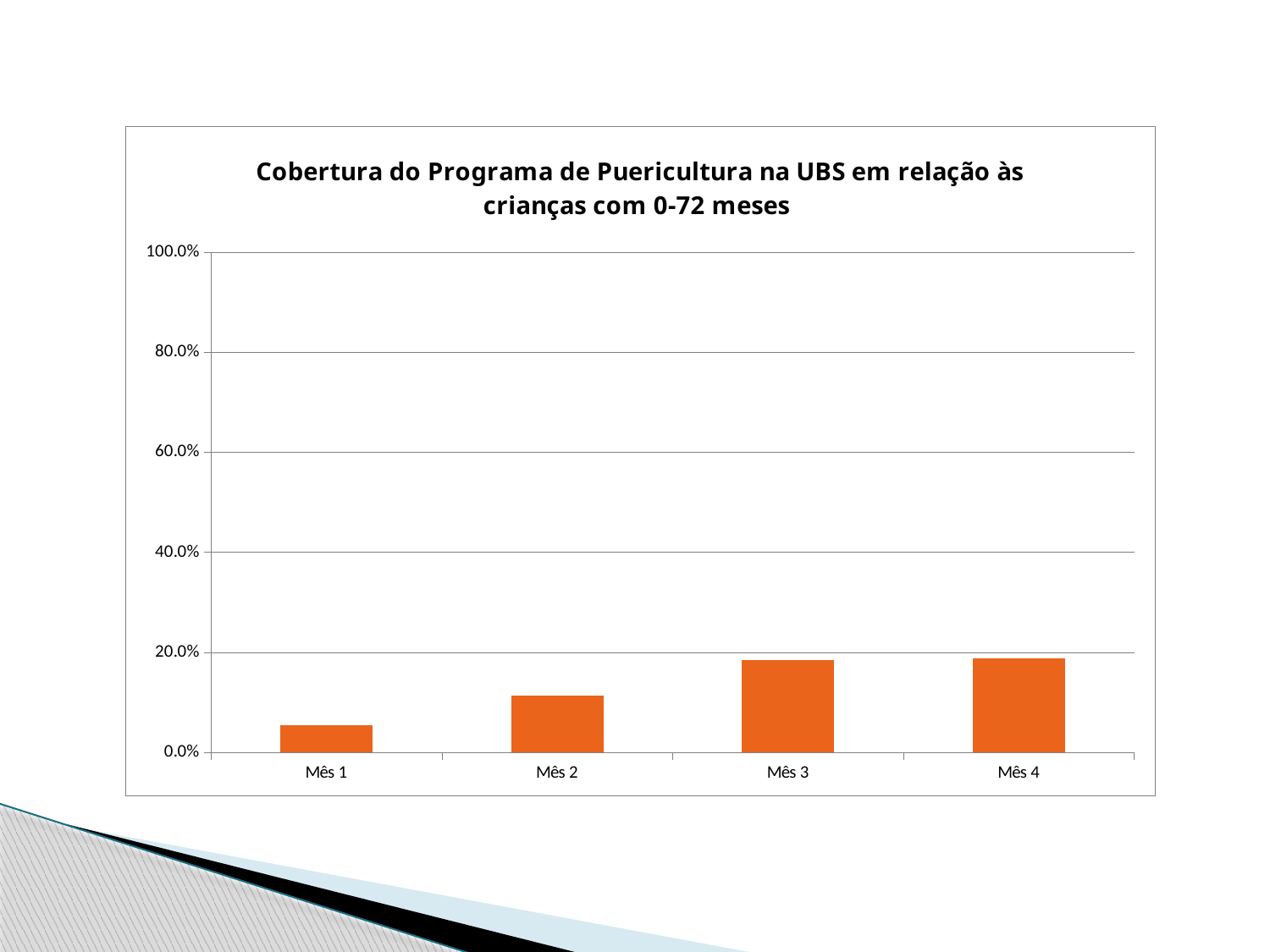
Which is larger, the value for Mês 2 or the value for Mês 4? Mês 4 What kind of chart is shown on the slide? bar chart Which is larger, the value for Mês 1 or the value for Mês 3? Mês 3 How many categories (months) are plotted on the x axis? 4 What colour are the bars in the chart? orange Is the value for Mês 2 greater or less than 20%? less Which month has the lowest coverage value? Mês 1 Is the value for Mês 3 greater or less than 20%? less Is the value for Mês 1 greater or less than 20%? less Do the values rise or fall from Mês 1 to Mês 4? rise What is the title of the chart? Cobertura do Programa de Puericultura na UBS em relação às crianças com 0-72 meses